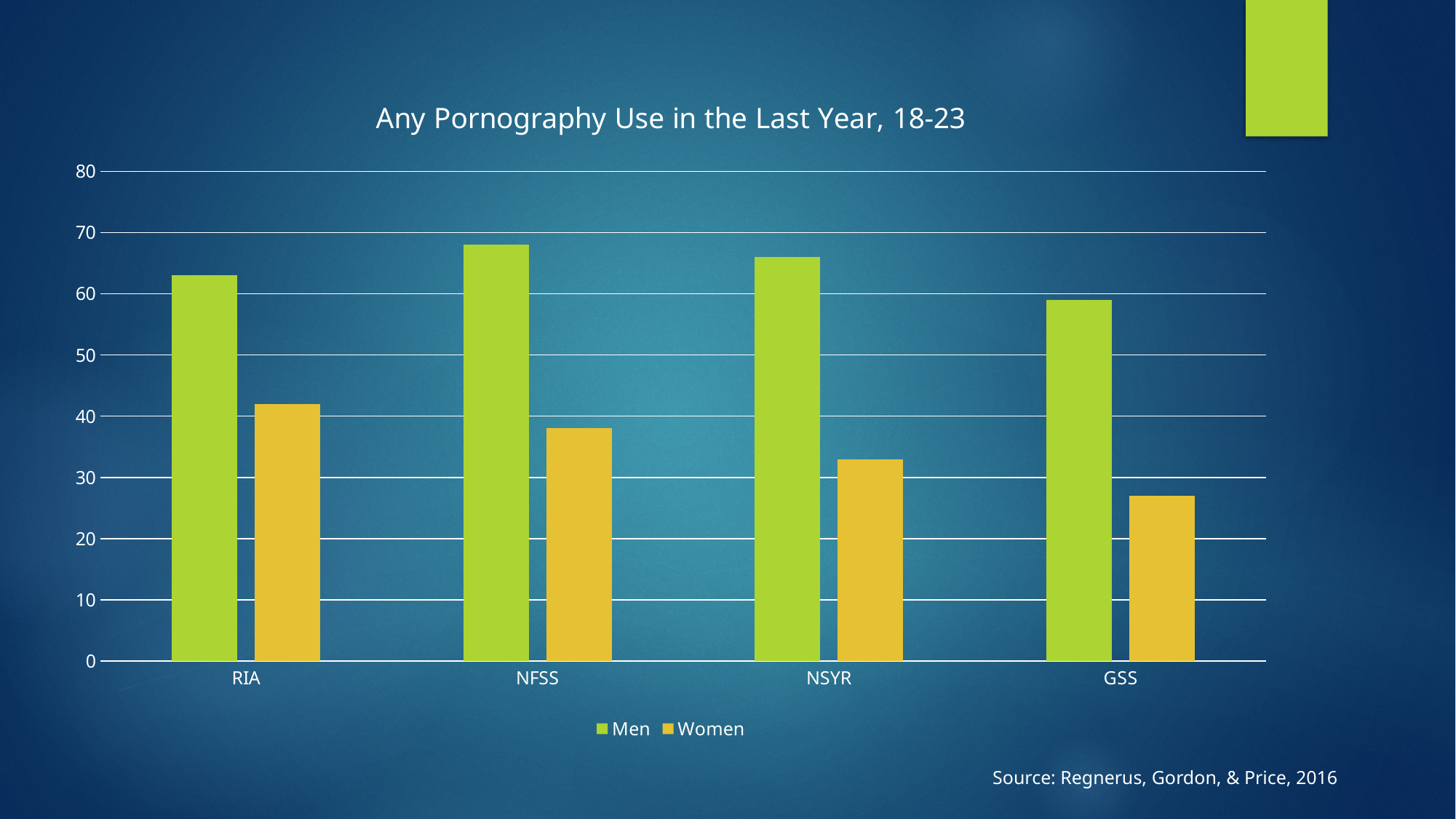
Which is larger in NSYR, the value for Men or the value for Women? Men Which category has the lowest value for Women? GSS Is the value for Women in NFSS greater or less than 40? less How many categories are shown on the x axis? 4 Which category has the lowest value for Men? GSS Do the values for Women rise or fall from RIA to GSS along the x axis? fall Which category has the highest value for Women? RIA Is the value for Women in GSS greater or less than 30? less What is the title of the chart? Any Pornography Use in the Last Year, 18-23 How many series does the legend list? 2 Is the value for Men in RIA greater or less than 60? greater What kind of chart is shown on the slide? bar chart